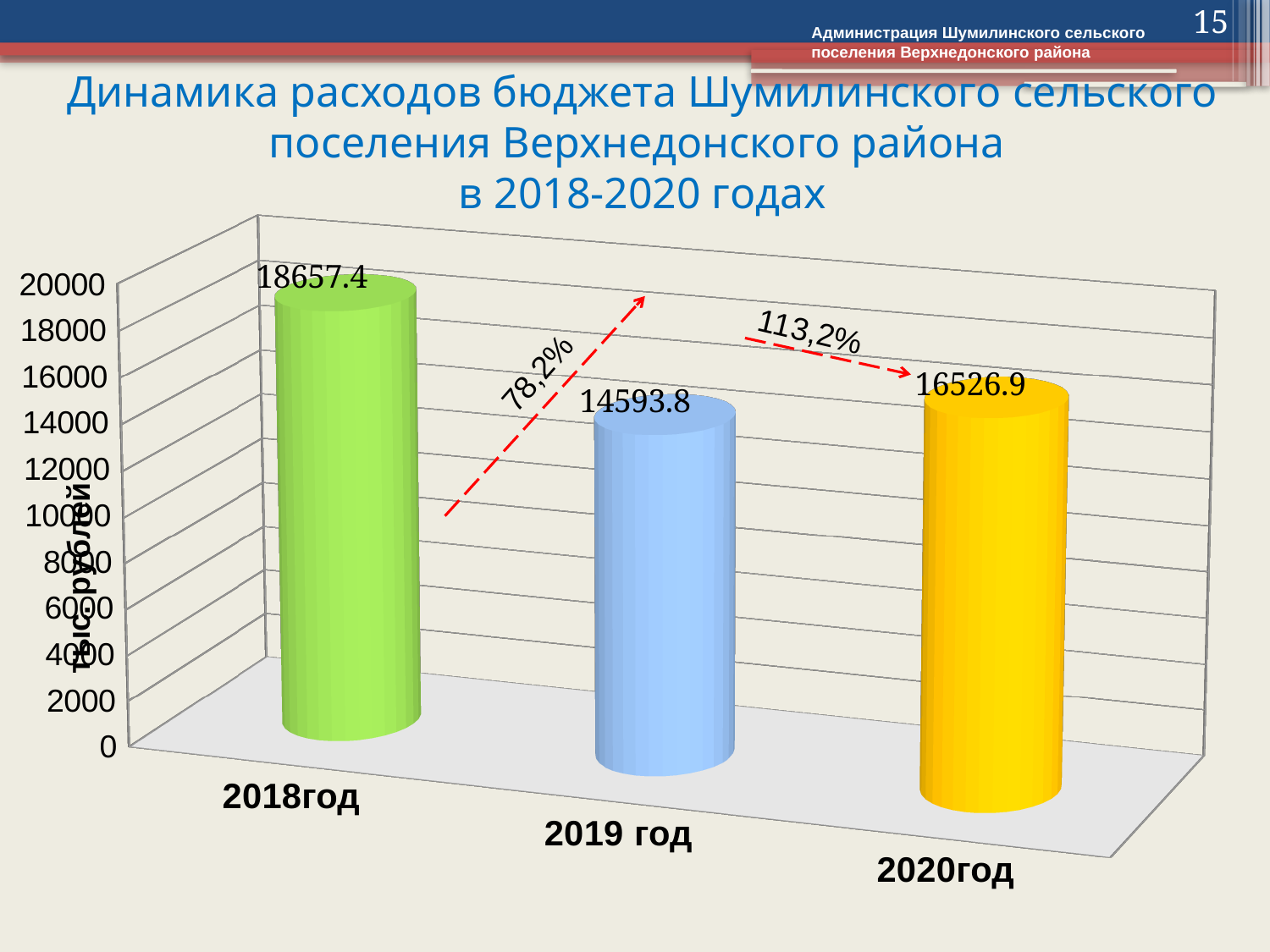
What is the budget expenditure value shown for 2019 год? 14593.8 Is the value for 2019 год greater or less than 16000? less What is the budget expenditure value shown for 2020год? 16526.9 Which year has the highest budget expenditure value? 2018год What is the difference between the values for 2020год and 2019 год? 1933.1 What is the budget expenditure value shown for 2018год? 18657.4 Which is larger, the value for 2020год or the value for 2019 год? 2020год What kind of chart is shown on the slide? bar chart What is the difference between the values for 2018год and 2019 год? 4063.6 Which year has the lowest budget expenditure value? 2019 год What percentage is written on the arrow between the 2019 год and 2020год bars? 113,2% How many years (categories) are shown on the chart? 3